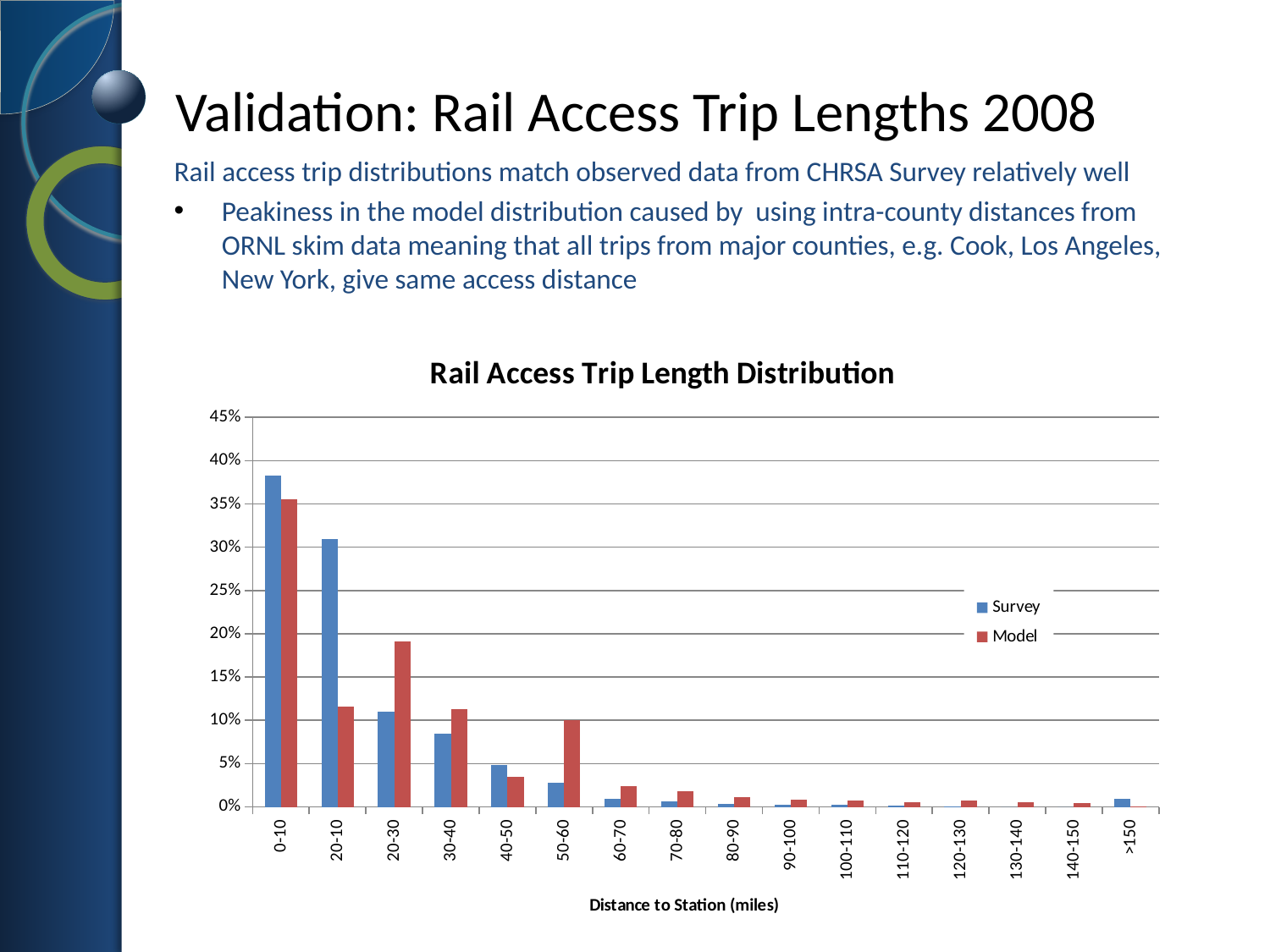
What is the x-axis title of the chart? Distance to Station (miles) What kind of chart is shown on the slide? bar chart For the 50-60 category, which series has the larger value, Survey or Model? Model Which distance category has the highest Model value? 0-10 Which distance category has the highest Survey value? 0-10 How many distance categories are shown on the x axis of the chart? 16 Is the Survey value for 0-10 greater or less than 35%? greater Do the Survey values generally rise or fall as distance increases from 0-10 to 90-100? fall How many series does the legend list in the Rail Access Trip Length Distribution chart? 2 Is the Survey value for 20-10 greater or less than 25%? greater Is the Model value for 20-30 greater or less than 15%? greater For the 20-10 category, which series has the larger value, Survey or Model? Survey